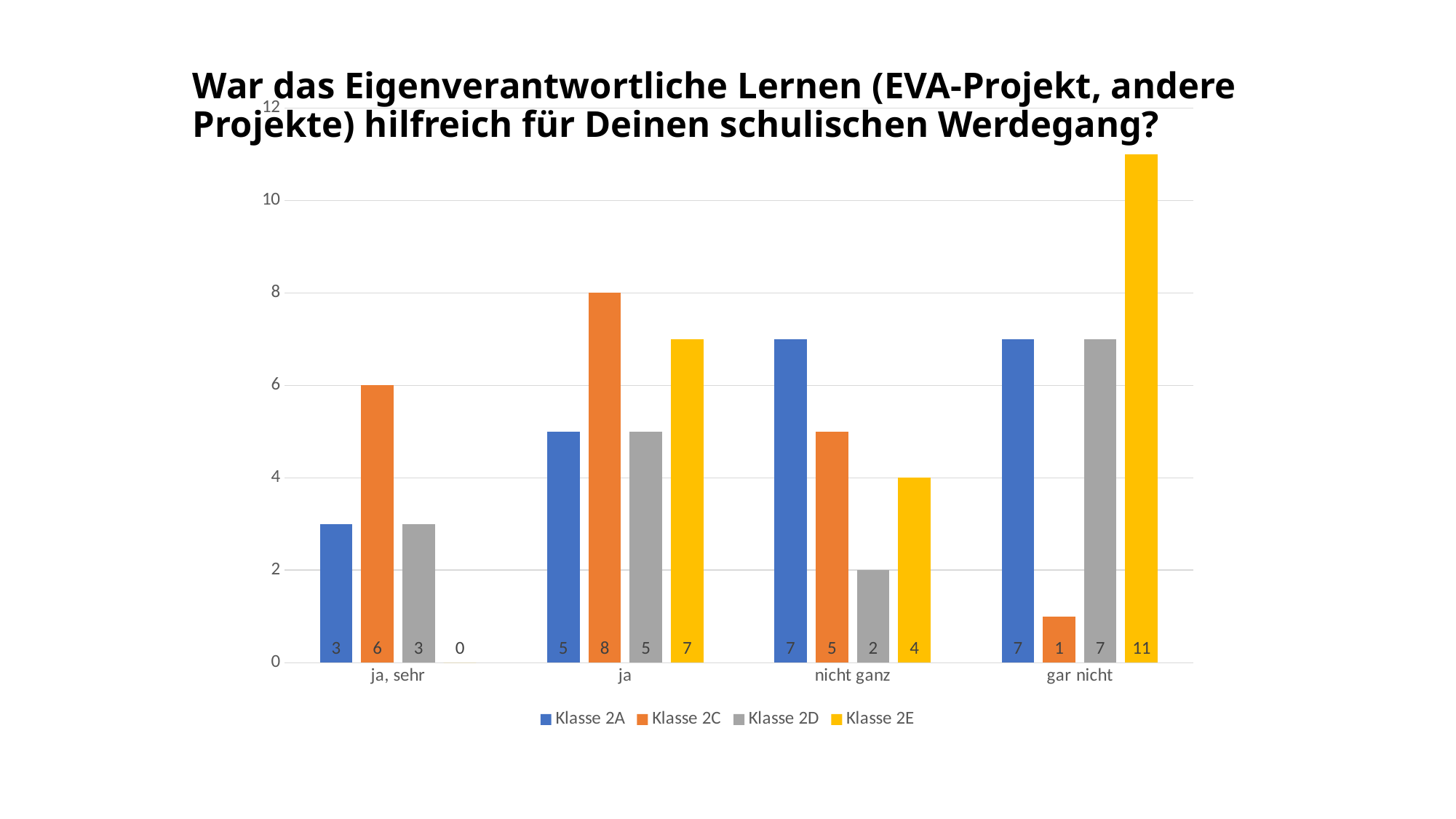
What is the value for Klasse 2E in the "gar nicht" category? 11 What kind of chart is shown on the slide? Bar chart What is the value for Klasse 2C in the "ja" category? 8 Which colour represents Klasse 2D in the chart? Grey What is the value for Klasse 2E in the "ja, sehr" category? 0 What is the value for Klasse 2D in the "nicht ganz" category? 2 How many series does the legend list? 4 Which category has the lowest value for Klasse 2C? gar nicht Which is larger in the "ja" category: Klasse 2A or Klasse 2C? Klasse 2C What is the difference between Klasse 2E and Klasse 2C in the "gar nicht" category? 10 How many categories are shown on the x axis? 4 Which category has the highest value for Klasse 2E? gar nicht